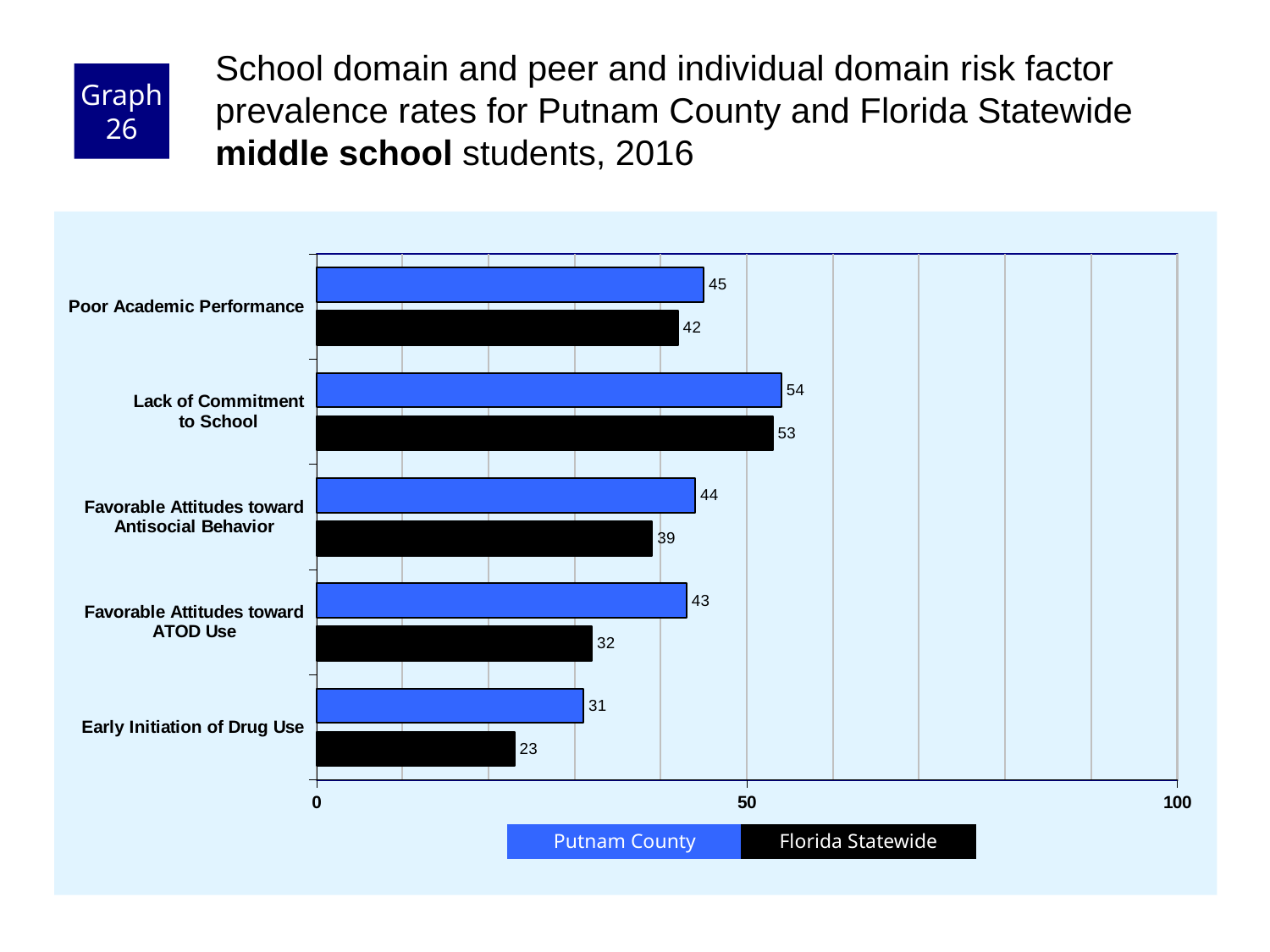
How many risk factors are shown on the chart? 5 Which risk factor has the highest Putnam County value? Lack of Commitment to School Which is larger for Favorable Attitudes toward Antisocial Behavior: the Putnam County value or the Florida Statewide value? Putnam County Which risk factor has the lowest Florida Statewide value? Early Initiation of Drug Use What is the difference between the Putnam County and Florida Statewide values for Early Initiation of Drug Use? 8 What is the Florida Statewide value for Favorable Attitudes toward ATOD Use? 32 Is the Putnam County value for Lack of Commitment to School greater or less than 50? greater How many series does the legend list? 2 What is the Florida Statewide value for Early Initiation of Drug Use? 23 What is the Putnam County value for Poor Academic Performance? 45 What kind of chart is shown on the slide? bar chart What is the difference between the Putnam County and Florida Statewide values for Favorable Attitudes toward ATOD Use? 11